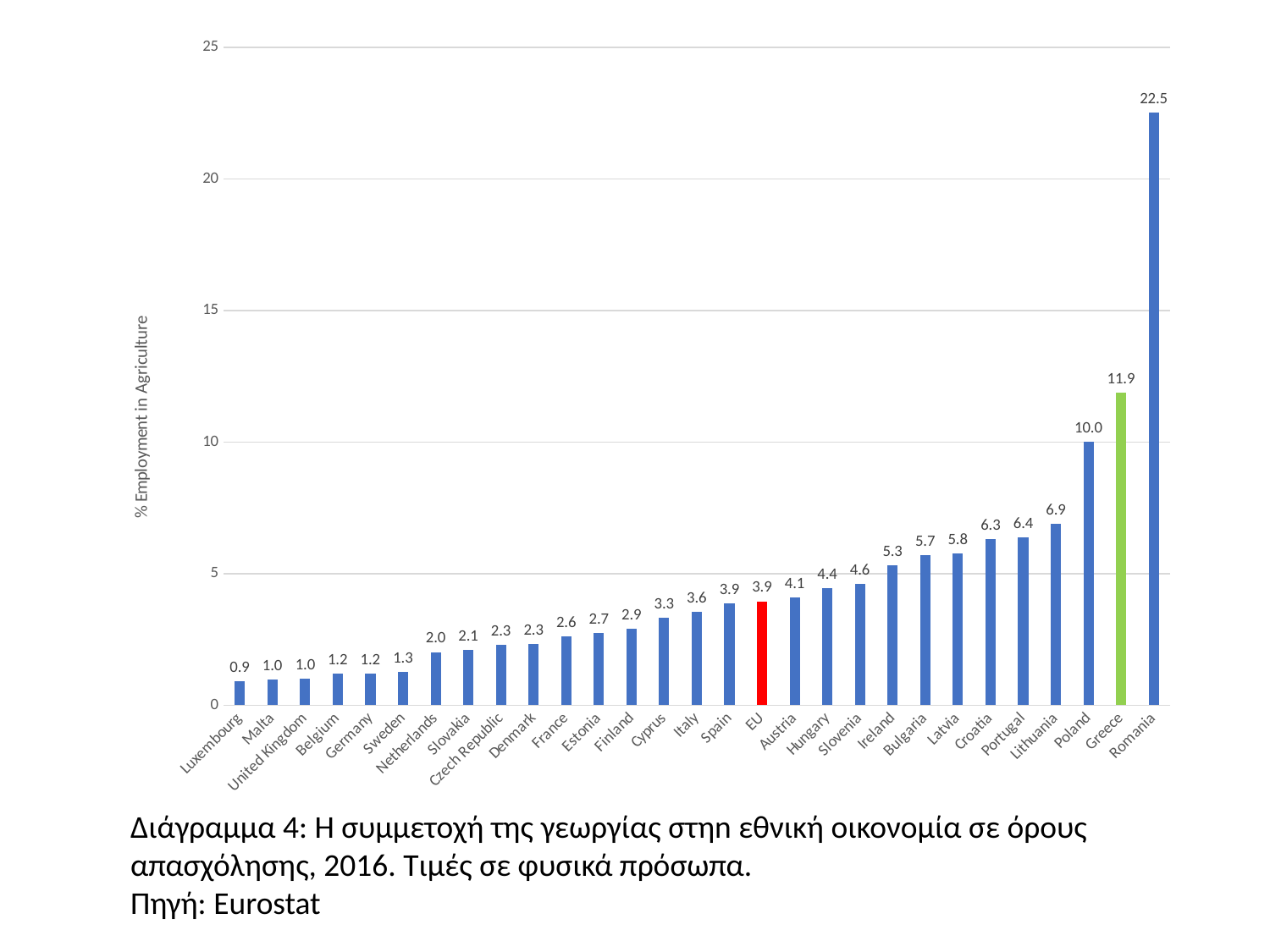
How many bars are shown in the chart? 29 What kind of chart is shown on the slide? Bar chart Do the values generally rise or fall from left to right along the x axis? Rise Which country has the lowest value? Luxembourg What is the value for Greece? 11.9 Which has a larger value, Portugal or Bulgaria? Portugal What is the label of the vertical axis? % Employment in Agriculture What is the difference between the values for Greece and the EU? 8.0 What is the value for the EU bar? 3.9 What is the value for Poland? 10.0 Which country has the highest value? Romania What is the difference between the values for Romania and Greece? 10.6